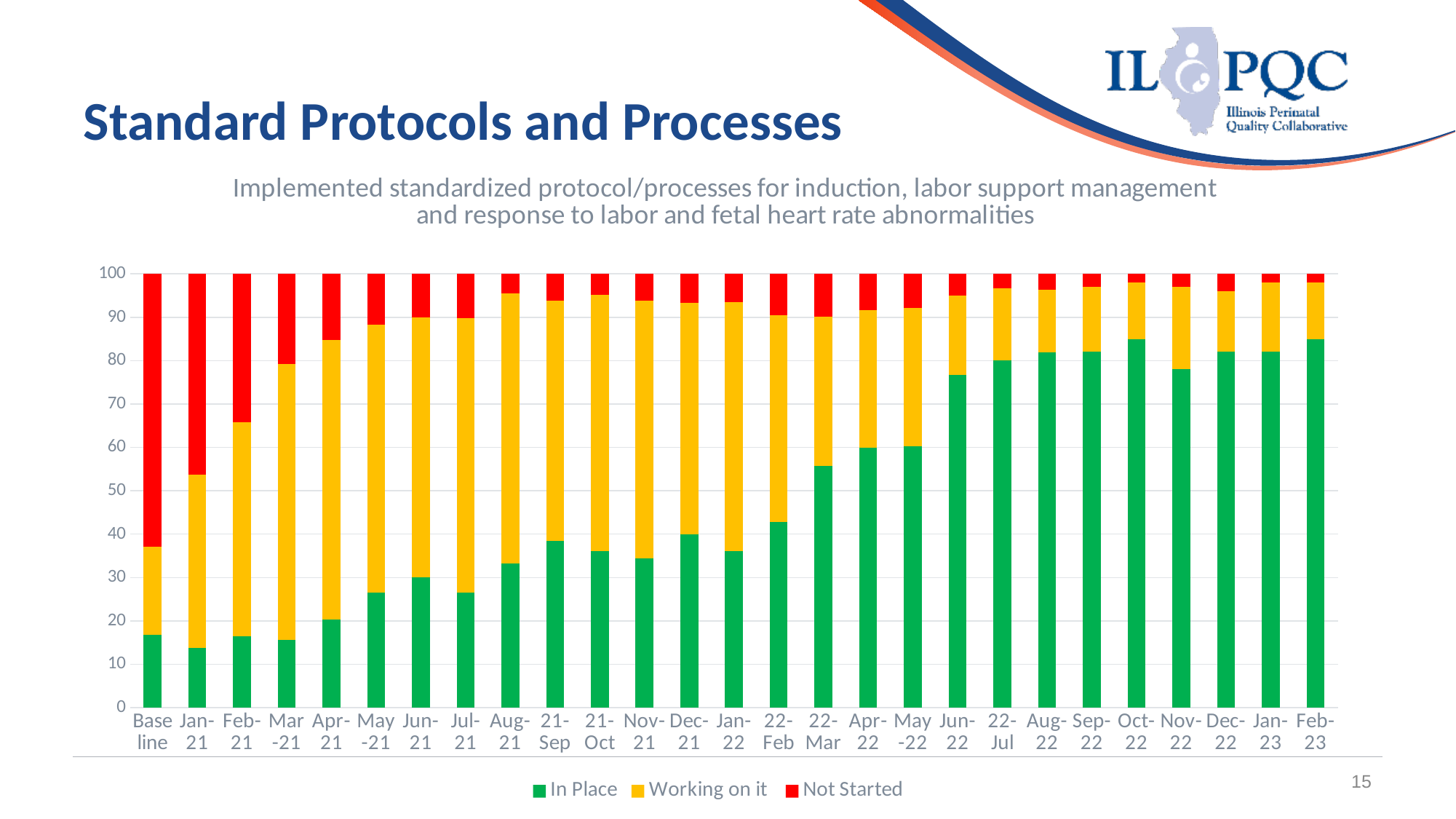
Which category has the largest Not Started segment? Baseline What is the total of the stacked bar for Baseline? 100 What kind of chart is shown on the slide? stacked bar chart Is the In Place value for Dec-21 greater or less than 50? less Is the In Place value for Baseline greater or less than 20? less How many series does the legend list? 3 Which has a larger In Place value, Jun-22 or Jan-22? Jun-22 Is the In Place value for Jun-22 greater or less than 70? greater Which series is shown in green? In Place How many categories are shown along the x axis? 27 Does the In Place series generally rise or fall from Baseline to Feb-23? rise